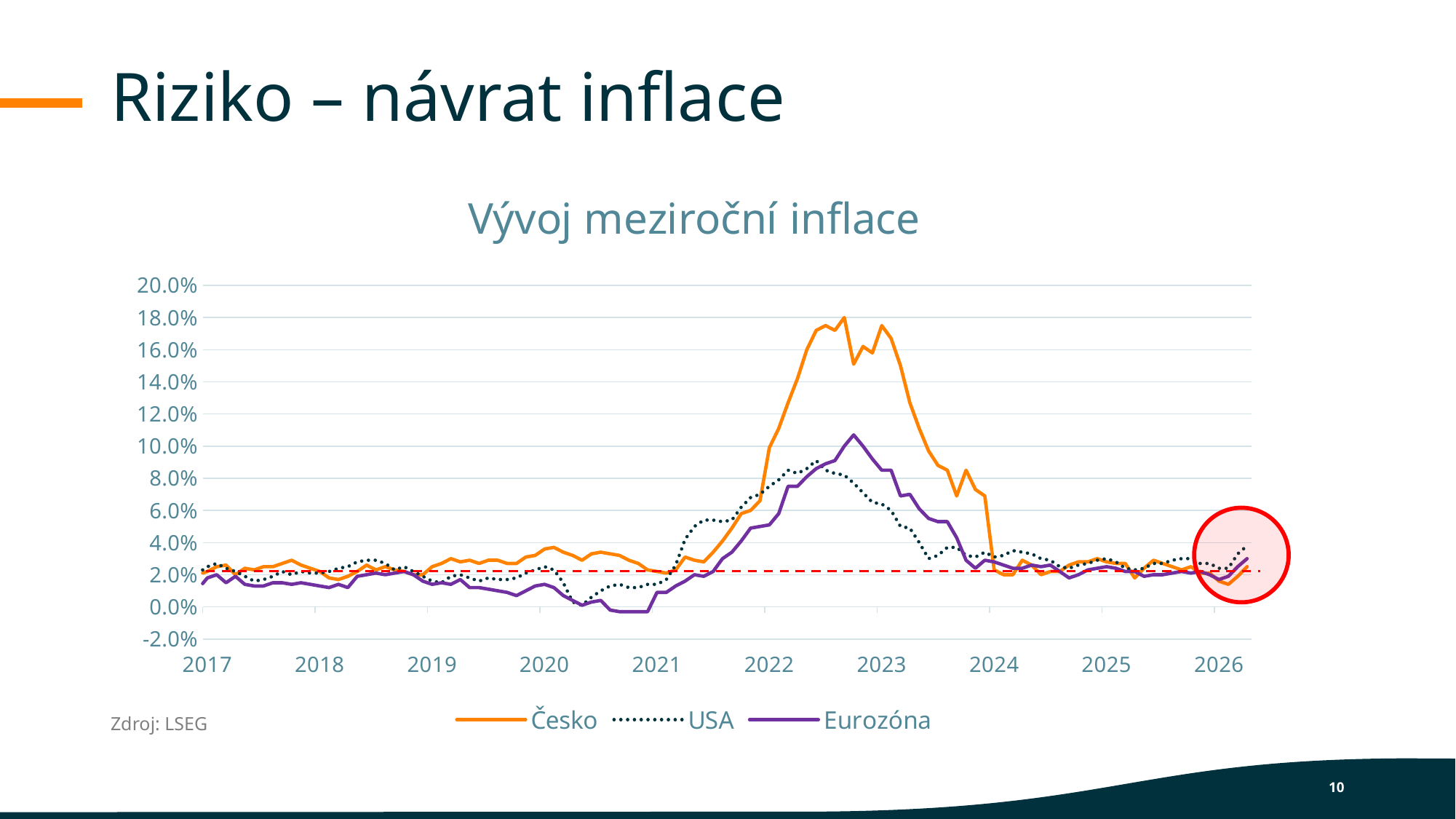
Which series reaches the highest value on the chart? Česko Is the peak value for USA greater or less than 10.0%? less Is the peak value for Eurozóna greater or less than 12.0%? less Is the peak value for Česko greater or less than 16.0%? greater How many year labels are shown on the x axis? 10 Which series is drawn as a dotted line? USA Does the Česko line rise or fall between its 2022 peak and 2024? fall What kind of chart is shown on the slide? line chart At their 2022 peaks, which is larger: Česko or Eurozóna? Česko How many series does the legend list? 3 What is the title of the chart? Vývoj meziroční inflace Which series dips lowest around 2020–2021? Eurozóna